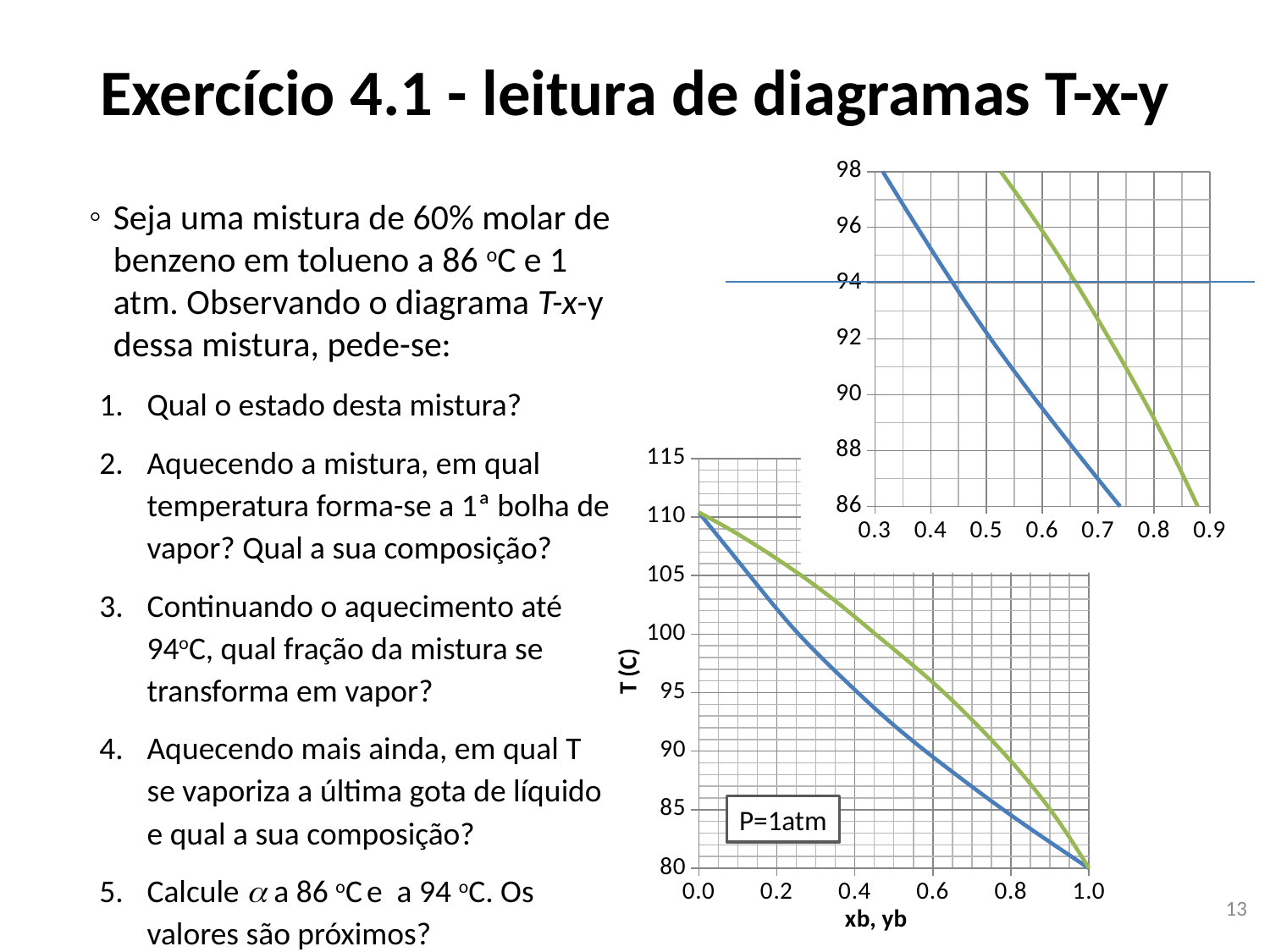
In the large chart at the bottom right, at xb, yb = 0.5, which line is higher, the green line or the blue line? green line What kind of chart is the large chart at the bottom right of the slide? line chart In the large chart at the bottom right, do the temperature values rise or fall as xb, yb increases from 0.0 to 1.0? fall In the zoomed chart at the top right, is the temperature of the green line at x = 0.6 greater or less than 94? greater In the zoomed chart at the top right, at x = 0.5, which line is higher, the blue line or the green line? green line In the zoomed chart at the top right, is the temperature of the blue line at x = 0.7 greater or less than 90? less What text is shown in the box inside the large chart at the bottom right? P=1atm In the zoomed chart at the top right, what is the lowest value shown on the vertical axis? 86 In the large chart at the bottom right, how many lines are plotted? 2 In the large chart at the bottom right, is the temperature of the blue line at xb, yb = 0.8 greater or less than 90? less What is the label of the vertical axis of the large chart at the bottom right? T (C)